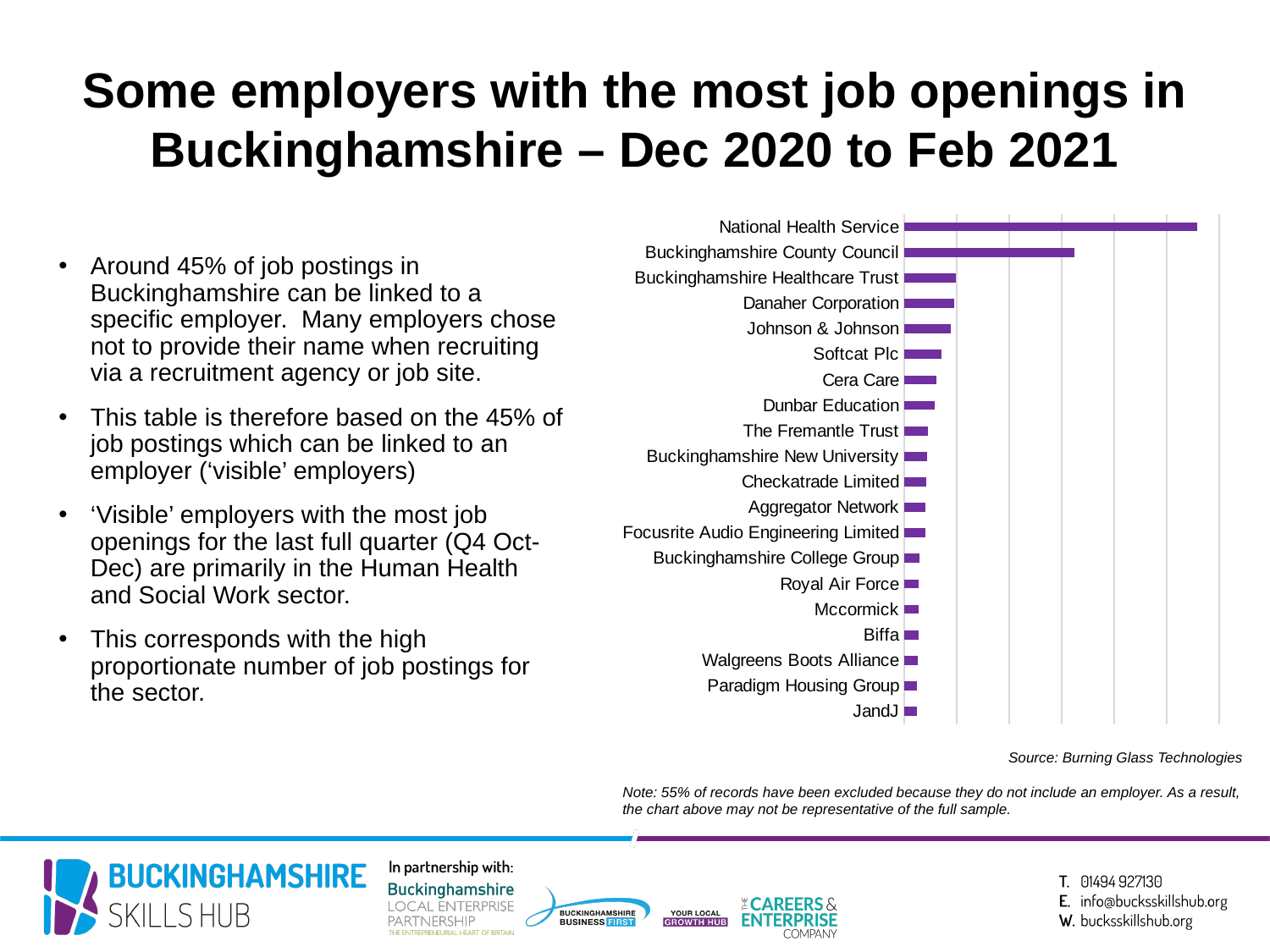
Which employer has the second-longest bar in the chart? Buckinghamshire County Council Which employer is listed at the bottom of the chart? JandJ Which has more job openings, Cera Care or Royal Air Force? Cera Care Do the bar lengths increase or decrease going from the top of the chart to the bottom? Decrease Which has more job openings, National Health Service or Buckinghamshire County Council? National Health Service What is the source of the data shown in the chart? Burning Glass Technologies Which has more job openings, Johnson & Johnson or Softcat Plc? Johnson & Johnson Which employer has the highest number of job openings in the chart? National Health Service How many employers are listed in the chart? 20 What kind of chart is shown on the slide? Bar chart